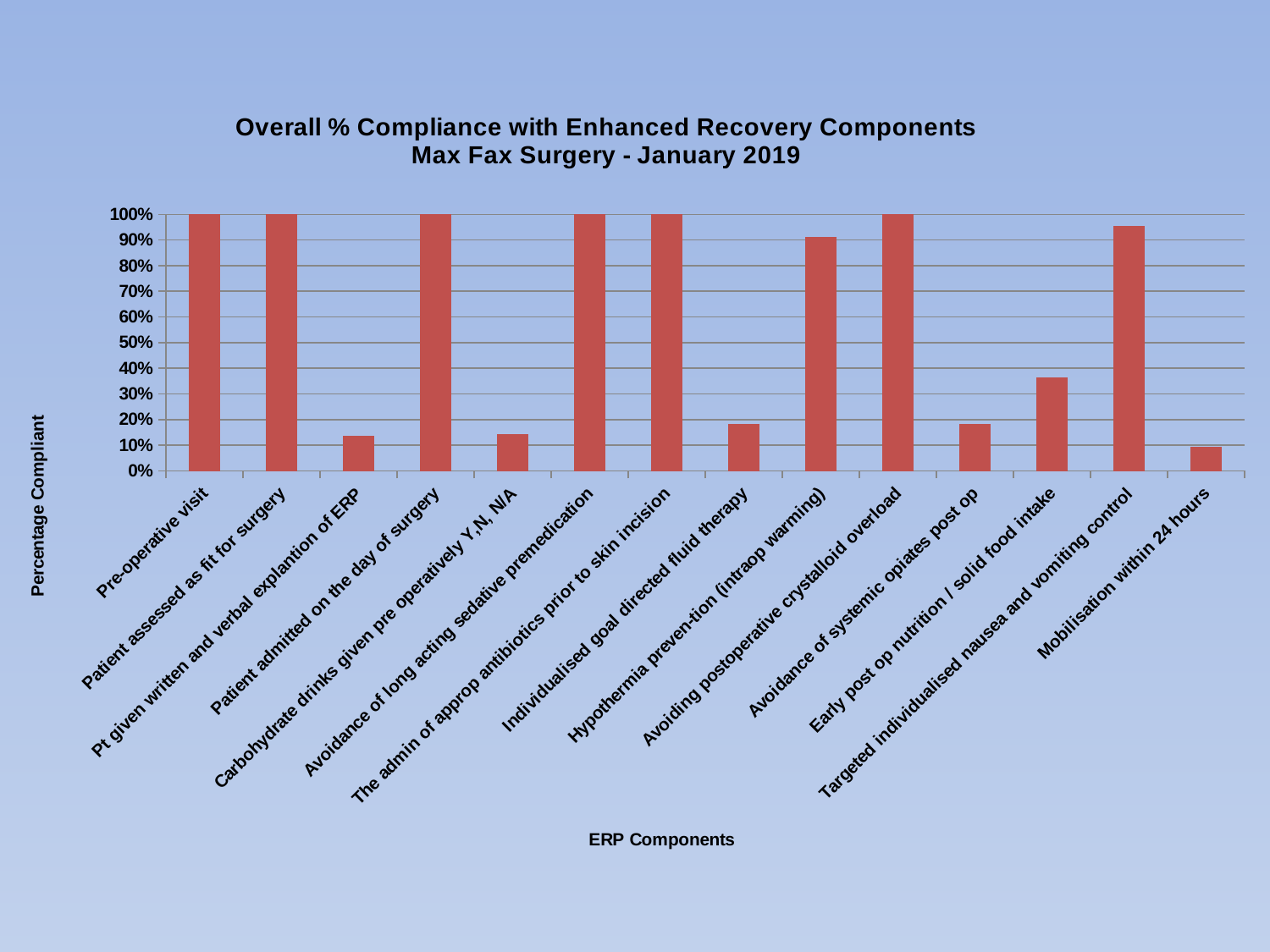
What is the percentage compliant for Avoiding postoperative crystalloid overload? 100% What is the percentage compliant for Pre-operative visit? 100% What is the title of the chart? Overall % Compliance with Enhanced Recovery Components Max Fax Surgery - January 2019 What is the percentage compliant for The admin of approp antibiotics prior to skin incision? 100% What is the label on the vertical axis of the chart? Percentage Compliant What kind of chart is shown on the slide? Bar chart Which is larger: the value for Early post op nutrition / solid food intake or the value for Avoidance of systemic opiates post op? Early post op nutrition / solid food intake Is the value for Early post op nutrition / solid food intake greater or less than 30%? greater Is the value for Carbohydrate drinks given pre operatively Y,N, N/A greater or less than 20%? less How many ERP components are plotted on the chart? 14 Is the value for Mobilisation within 24 hours greater or less than 20%? less